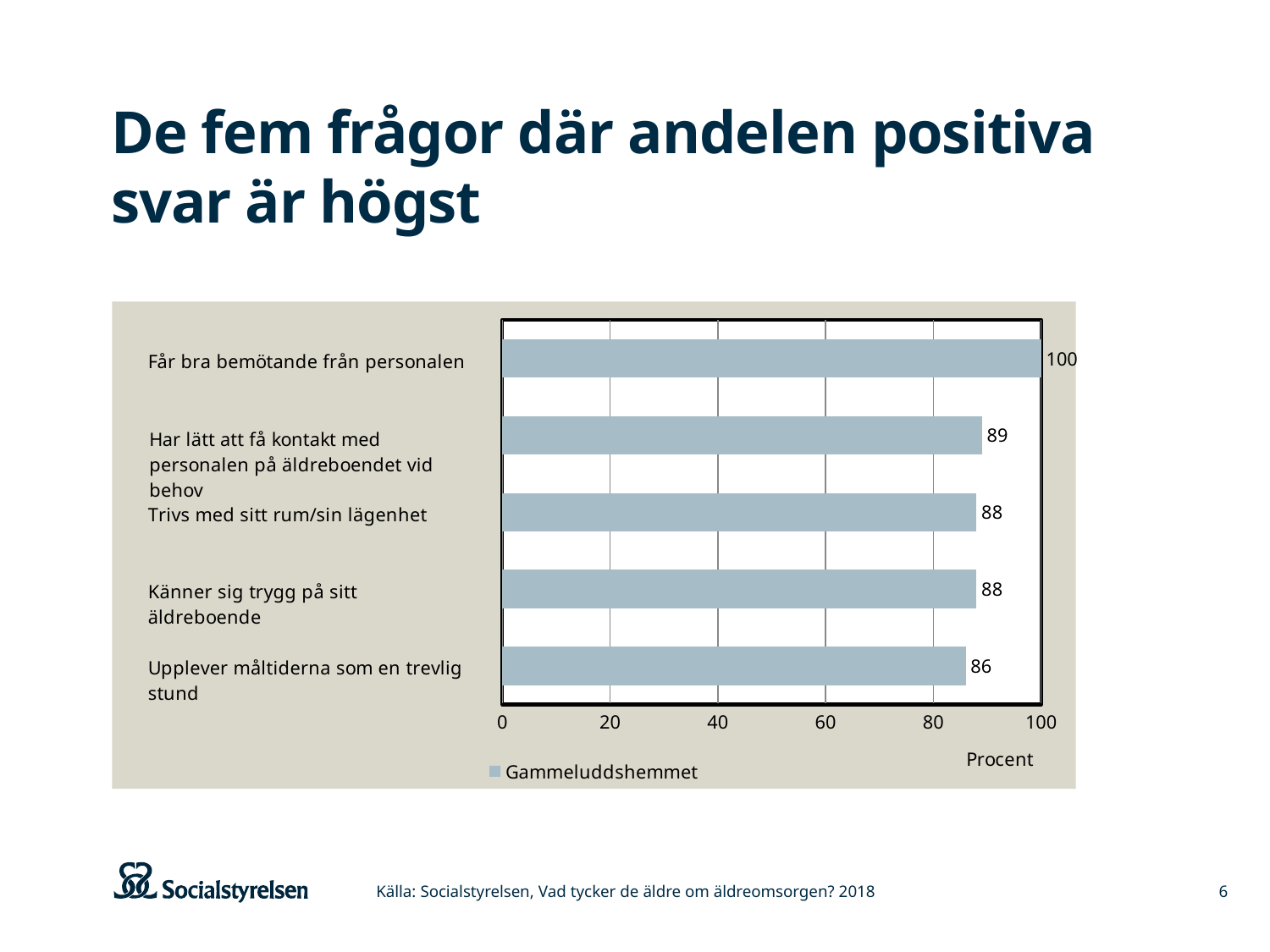
What value is shown for "Får bra bemötande från personalen"? 100 How many categories are shown in the chart? 5 What is the difference between the values for "Har lätt att få kontakt med personalen på äldreboendet vid behov" and "Känner sig trygg på sitt äldreboende"? 1 How many series does the legend list? 1 What is the difference between the values for "Får bra bemötande från personalen" and "Upplever måltiderna som en trevlig stund"? 14 Which is larger: the value for "Har lätt att få kontakt med personalen på äldreboendet vid behov" or the value for "Upplever måltiderna som en trevlig stund"? Har lätt att få kontakt med personalen på äldreboendet vid behov Which category has the highest value? Får bra bemötande från personalen What value is shown for "Trivs med sitt rum/sin lägenhet"? 88 What kind of chart is shown on the slide? Bar chart What value is shown for "Har lätt att få kontakt med personalen på äldreboendet vid behov"? 89 Which category has the lowest value? Upplever måltiderna som en trevlig stund What value is shown for "Upplever måltiderna som en trevlig stund"? 86